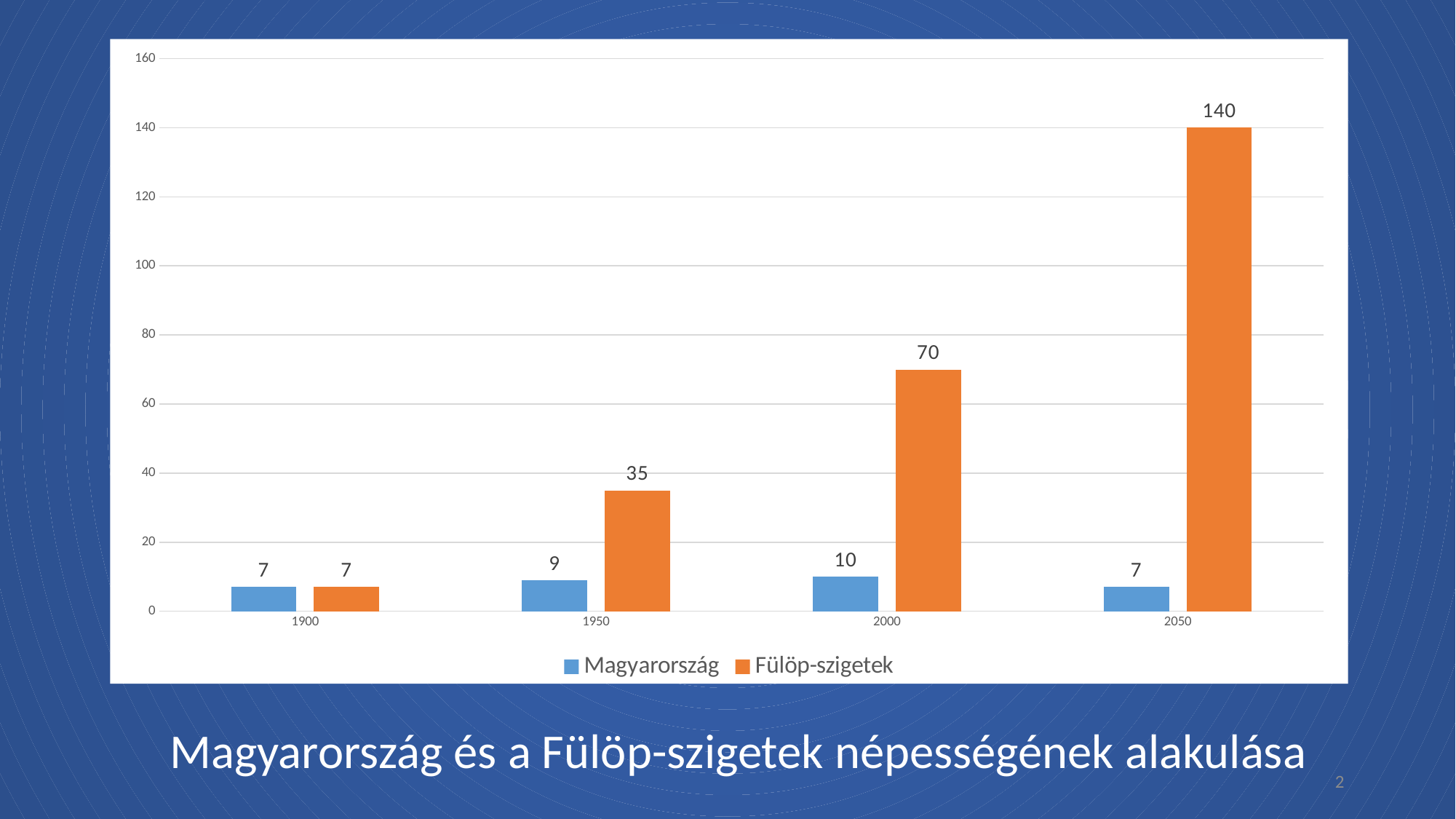
How many years are shown on the x axis? 4 What is the value for Fülöp-szigetek in 2050? 140 In which year is the value for Fülöp-szigetek highest? 2050 What is the value for Magyarország in 2000? 10 Do the values for Fülöp-szigetek rise or fall from 1900 to 2050? Rise In which year is the value for Magyarország highest? 2000 What is the difference between the Fülöp-szigetek values for 2050 and 1950? 105 Which is larger in 1950, Magyarország or Fülöp-szigetek? Fülöp-szigetek What is the difference between Fülöp-szigetek and Magyarország in 2000? 60 How many series does the legend list? 2 What kind of chart is shown on the slide? Bar chart What is the value for Fülöp-szigetek in 1950? 35